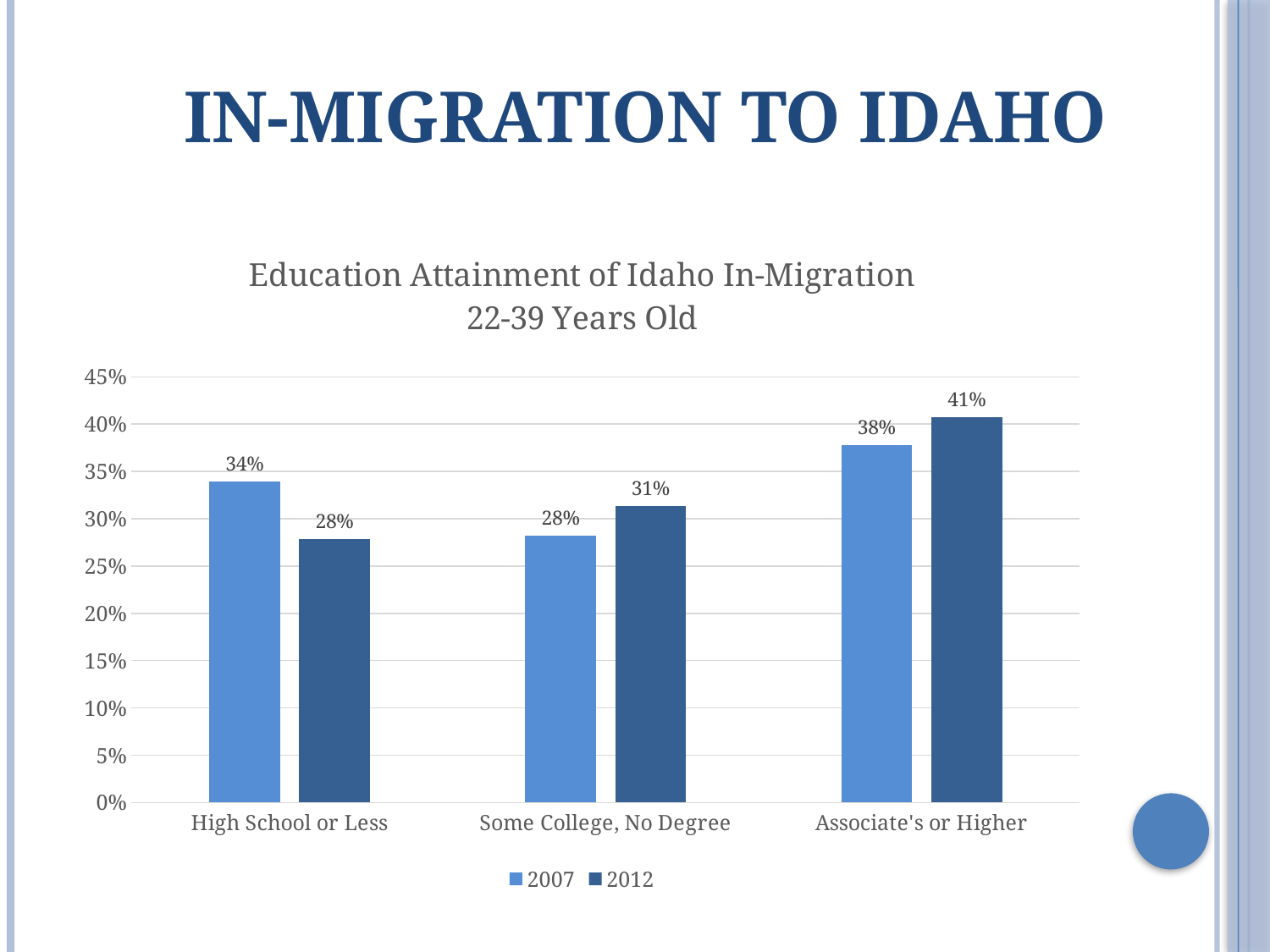
What is the title of the chart? Education Attainment of Idaho In-Migration 22-39 Years Old How many series does the legend list? 2 Which is larger for Associate's or Higher, the 2007 value or the 2012 value? 2012 What is the 2012 value for Some College, No Degree? 31% What is the difference between the 2012 and 2007 values for High School or Less? 6% What is the 2007 value for High School or Less? 34% Is the 2007 value for Associate's or Higher greater or less than 35%? greater Which category has the lowest 2007 value? Some College, No Degree What kind of chart is shown on the slide? Bar chart How many education categories are shown on the x axis? 3 What is the 2012 value for Associate's or Higher? 41% Which category has the highest 2012 value? Associate's or Higher